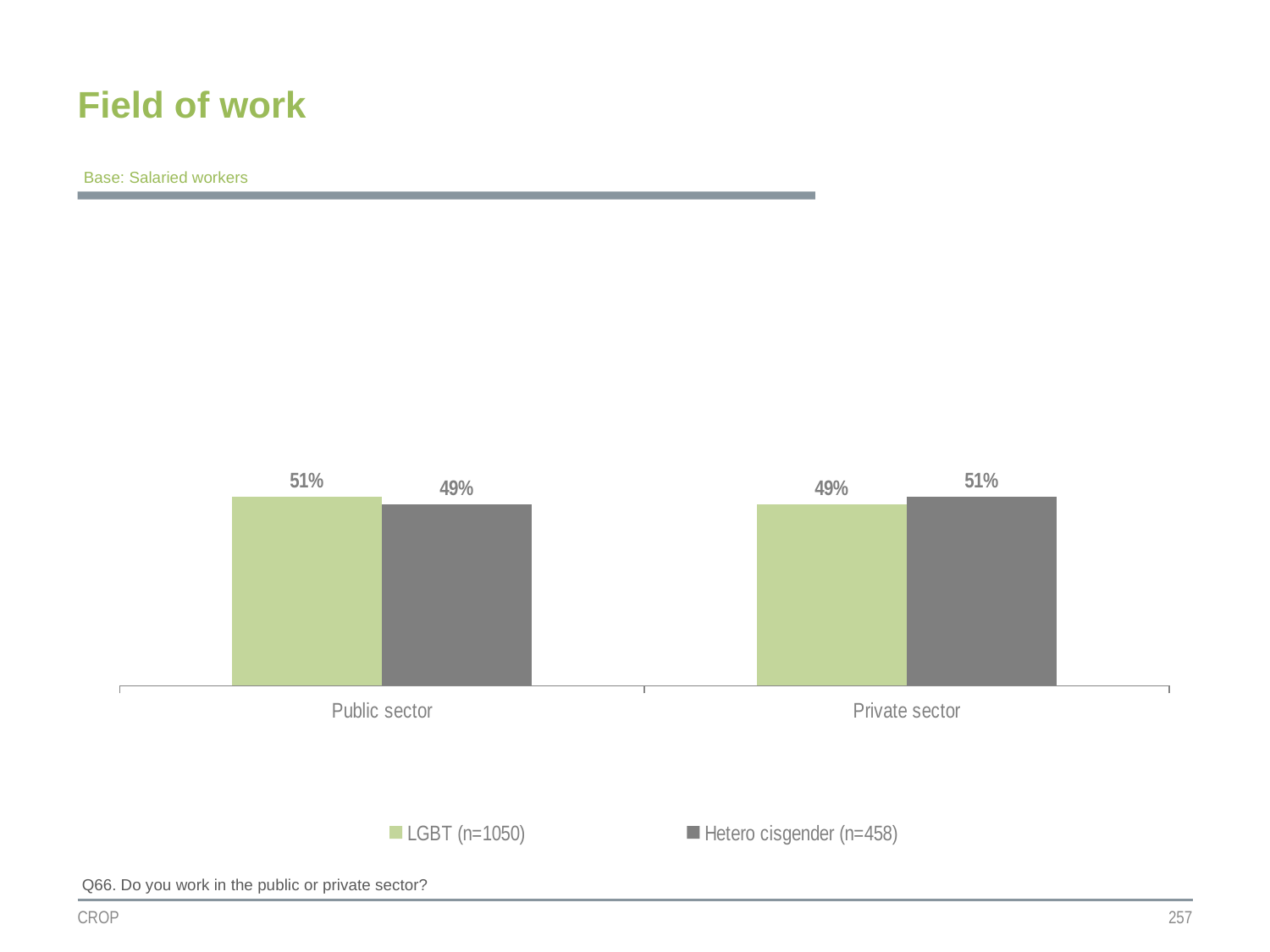
What is the difference between the LGBT and Hetero cisgender values for the Public sector? 2% What percentage of Hetero cisgender respondents work in the private sector? 51% What is the sample size (n) for the LGBT series shown in the legend? 1050 How many series does the legend list? 2 What kind of chart is shown on the slide? Bar chart What is the value for LGBT in the Private sector category? 49% What is the value for Hetero cisgender in the Public sector category? 49% What is the total of the LGBT values across Public sector and Private sector? 100% What is the title of the slide? Field of work What percentage of LGBT respondents work in the public sector? 51% How many categories are shown on the x axis? 2